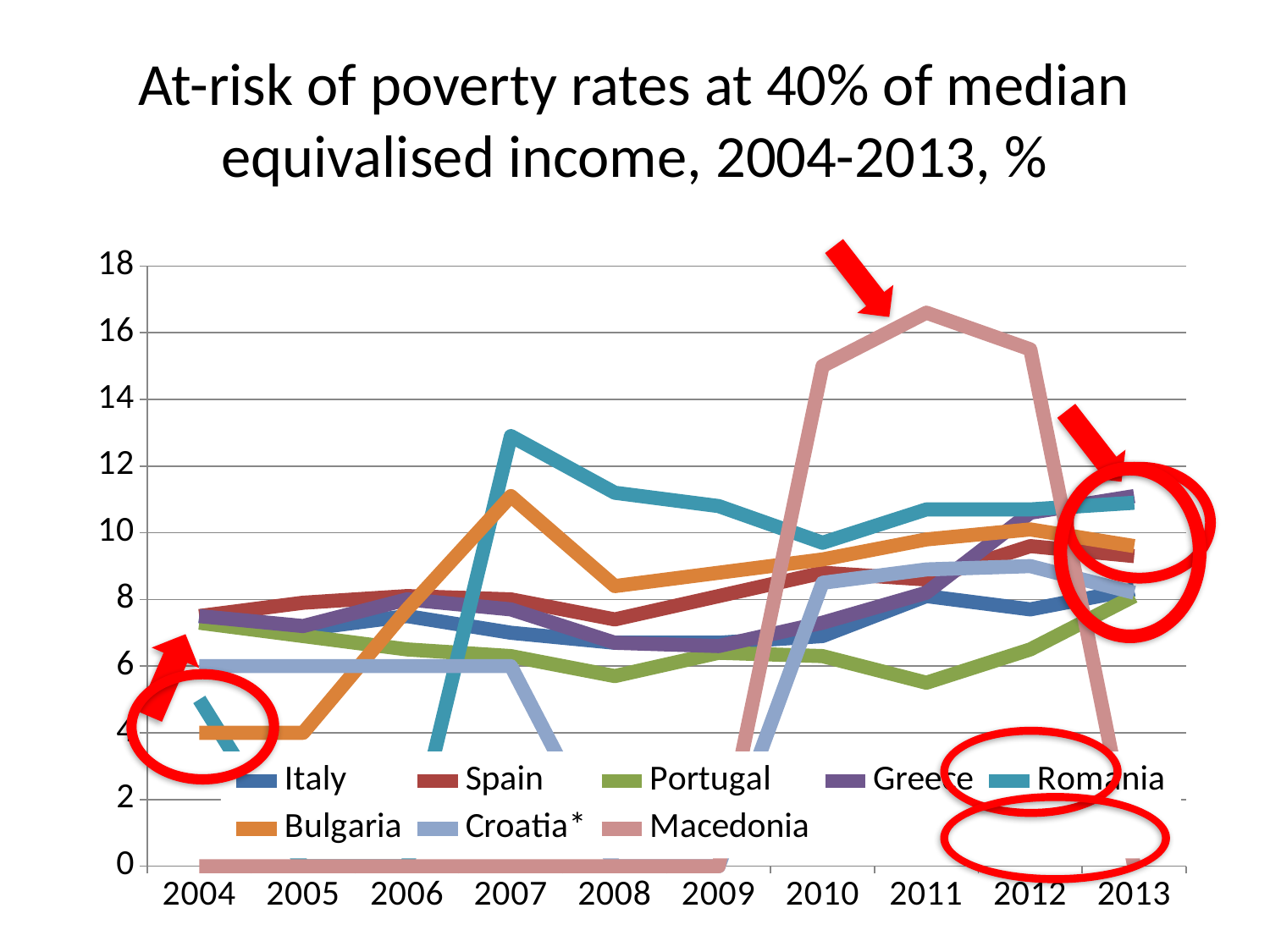
Is the value for Bulgaria in 2004 greater or less than 6? less What kind of chart is shown on the slide? line chart Is the value for Romania in 2007 greater or less than 12? greater Does the Bulgaria line rise or fall between 2004 and 2007? rise How many years are shown along the x axis? 10 In which year does the Macedonia line reach its peak? 2011 What is the title of the chart? At-risk of poverty rates at 40% of median equivalised income, 2004-2013, % Is the value for Macedonia in 2011 greater or less than 16? greater Which country has the lowest value in 2011? Portugal How many series does the legend list? 8 Which is higher in 2007, Romania or Bulgaria? Romania Which country reaches the highest value anywhere on the chart? Macedonia